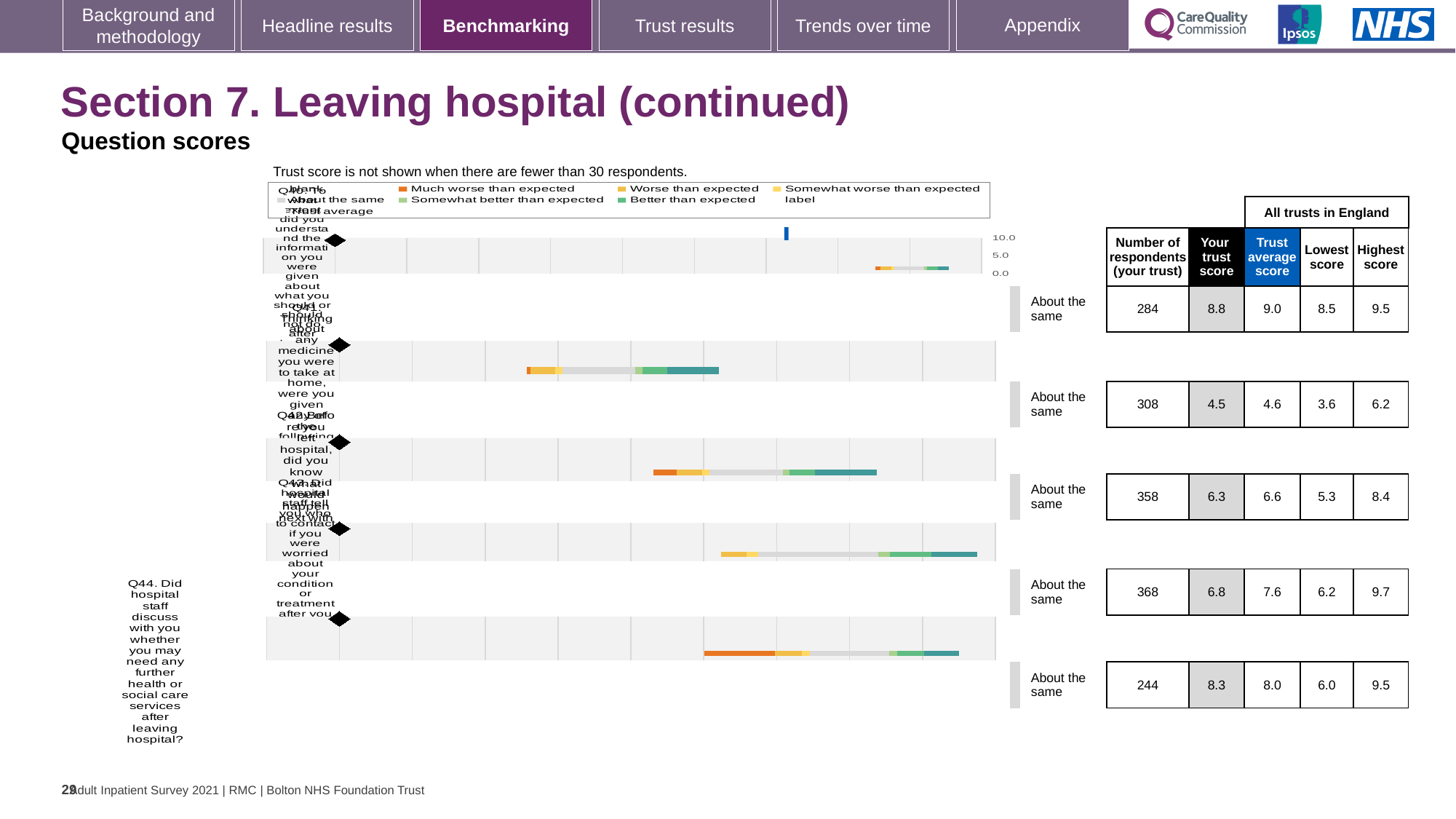
Which legend entry is shown in orange? Much worse than expected What is the highest value shown on the chart's numeric axis? 10.0 What is the question number of the bottom row of the chart, about whether hospital staff discussed further health or social care services after leaving hospital? Q44 What kind of chart is shown on the slide? Bar chart According to the note above the chart, the trust score is not shown when there are fewer than how many respondents? 30 How many question rows (bars) are plotted in the chart? 5